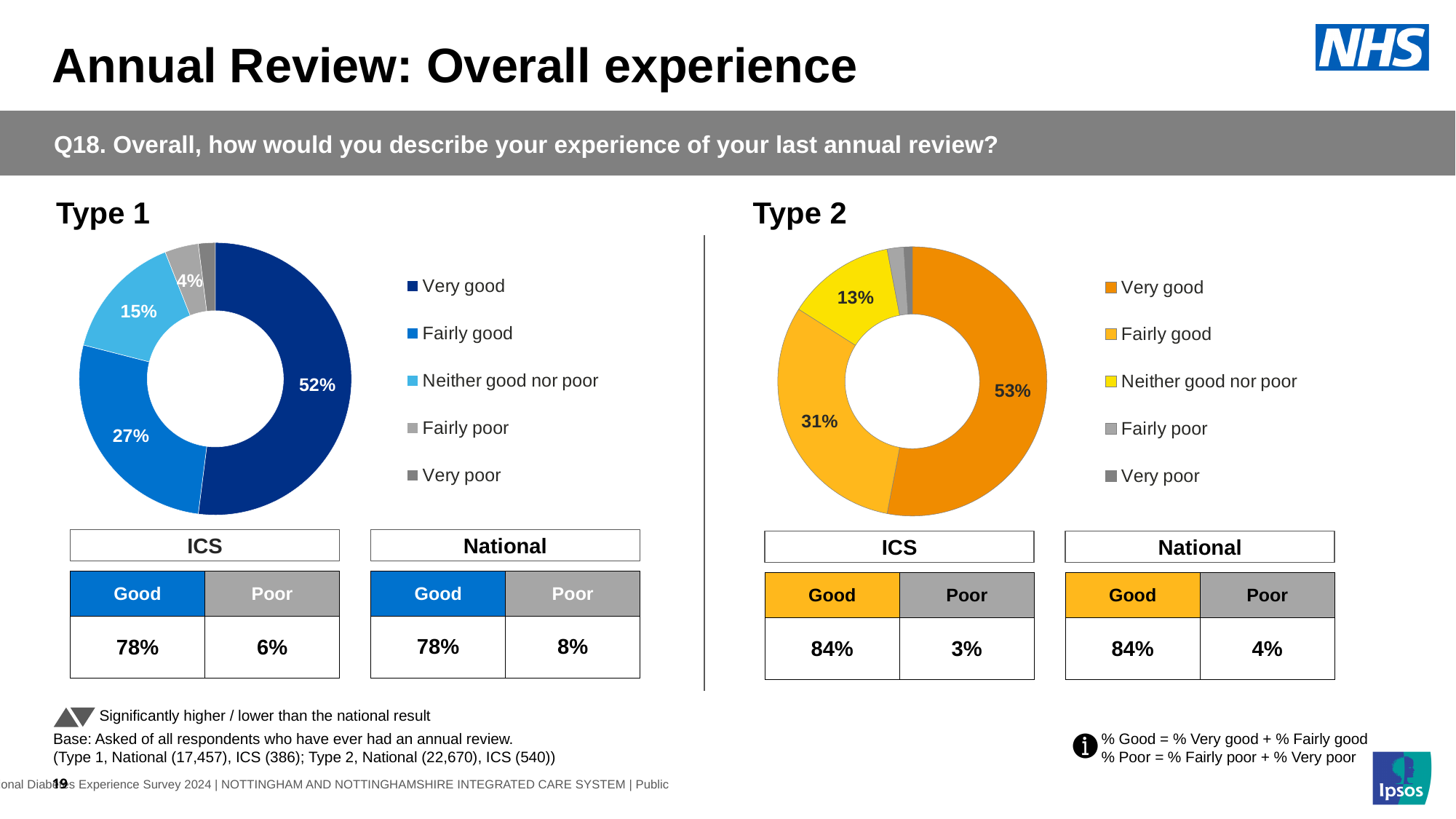
In the Type 2 chart, which response category has the largest share? Very good What kind of chart is used for Type 1 and Type 2? Donut (pie) chart In the Type 1 chart, what percentage of respondents said 'Fairly good'? 27% In the Type 1 chart, which response category has the largest share? Very good Which is larger: 'Fairly good' in the Type 1 chart or 'Fairly good' in the Type 2 chart? Type 2 In the Type 2 chart, what percentage of respondents said 'Fairly good'? 31% In the Type 1 chart, what is the difference in percentage points between 'Very good' and 'Fairly good'? 25 In the Type 1 chart, what percentage of respondents said 'Fairly poor'? 4% In the Type 2 chart, what percentage of respondents said 'Very good'? 53% In the Type 1 chart, what percentage of respondents said 'Very good'? 52% In the Type 2 chart, what percentage of respondents said 'Neither good nor poor'? 13% In the Type 1 chart, what percentage of respondents said 'Neither good nor poor'? 15%